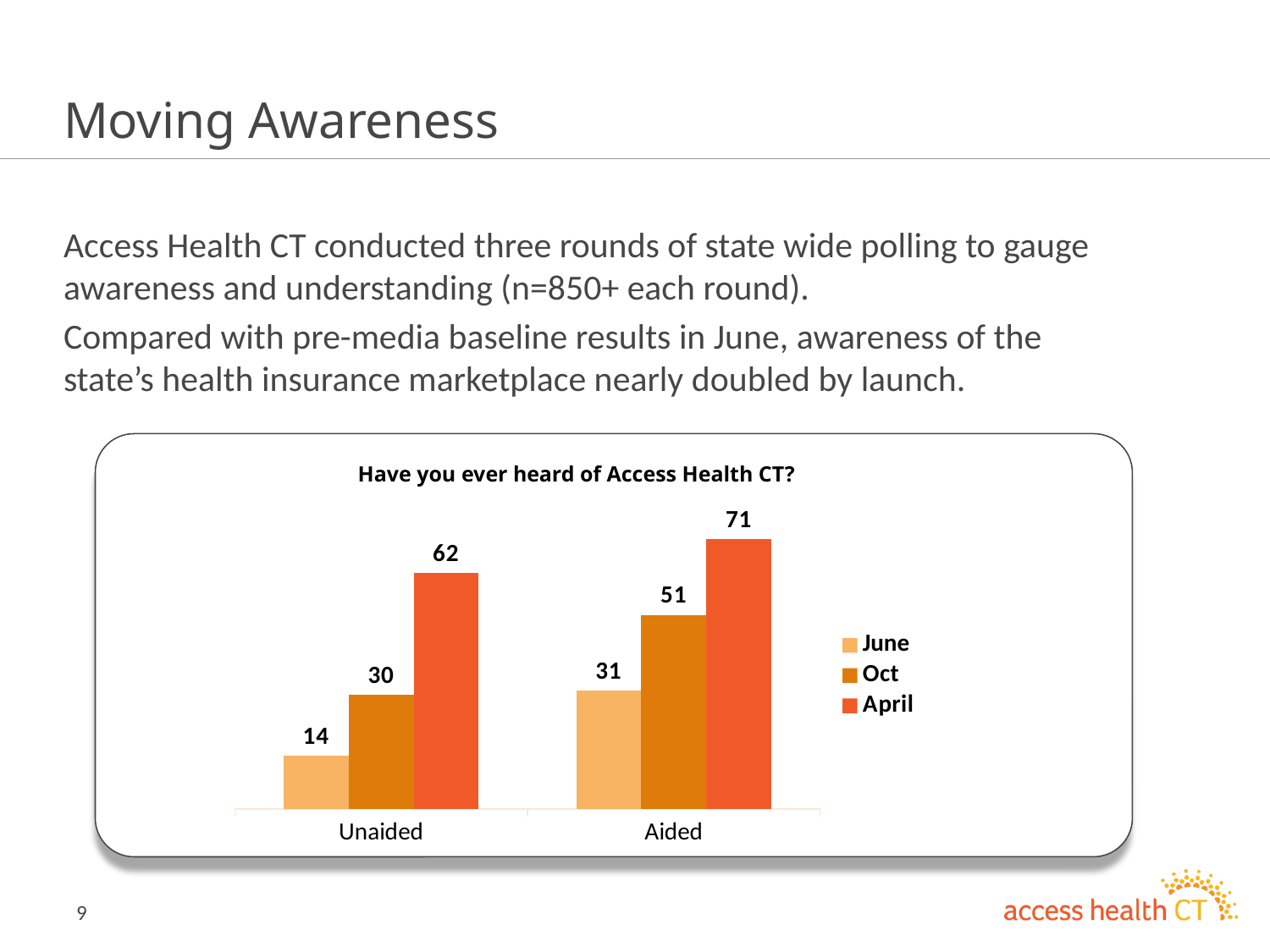
Which series has the lowest value for Unaided? June What is the April value for Aided? 71 Which series has the highest value for Aided? April What kind of chart is shown? Bar chart What is the June value for Unaided? 14 Which is larger, the June value for Aided or the Oct value for Unaided? June value for Aided How many series does the legend list? 3 How many categories are shown on the x axis? 2 What is the Oct value for Unaided? 30 What is the title of the chart? Have you ever heard of Access Health CT? What is the difference between the April and June values for Unaided? 48 What is the difference between the Aided and Unaided values for Oct? 21